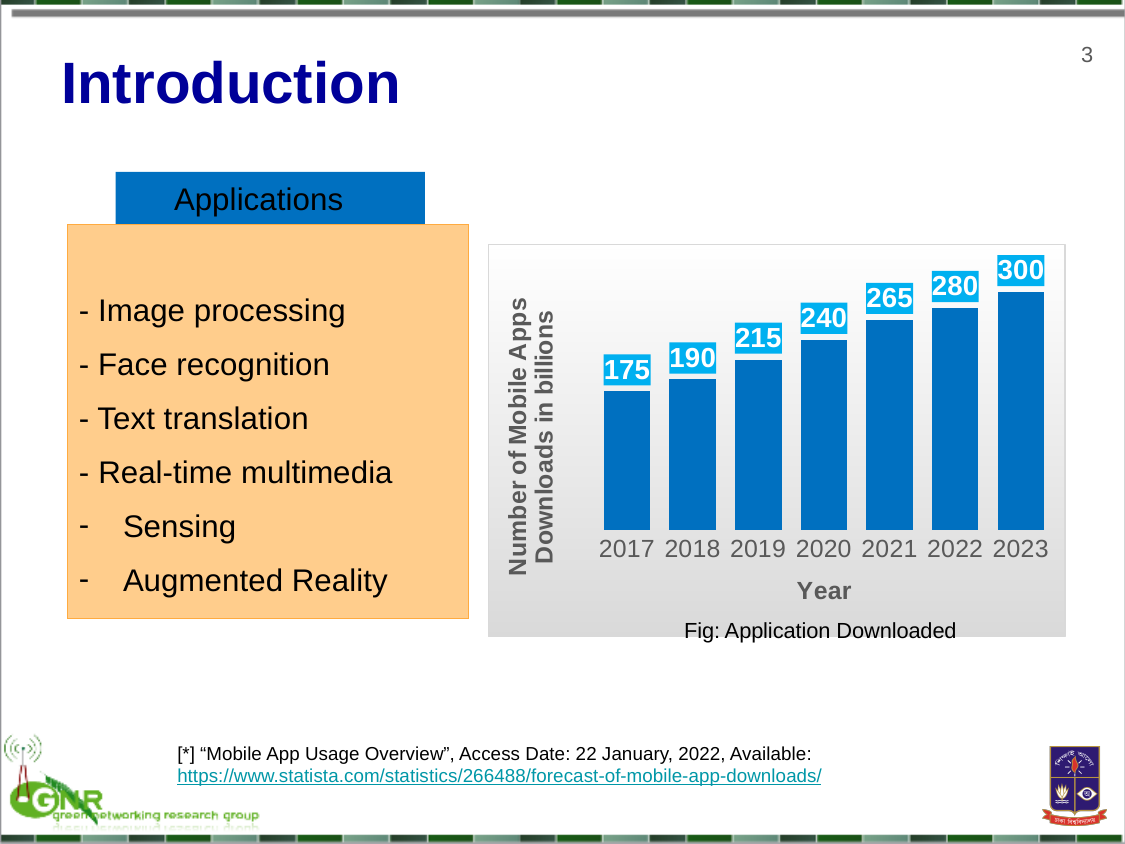
How many years are shown on the x axis of the chart? 7 Which year has the highest number of mobile app downloads? 2023 Which year has more mobile app downloads, 2018 or 2022? 2022 What is the number of mobile app downloads in billions for 2017? 175 What is the difference in mobile app downloads (in billions) between 2023 and 2017? 125 Do the mobile app download values rise or fall from 2017 to 2023? Rise Which year has the lowest number of mobile app downloads? 2017 What is the number of mobile app downloads in billions for 2020? 240 What is the difference in mobile app downloads (in billions) between 2021 and 2019? 50 What is the label of the y axis of the chart? Number of Mobile Apps Downloads in billions What is the number of mobile app downloads in billions for 2023? 300 What kind of chart is shown on the slide? Bar chart